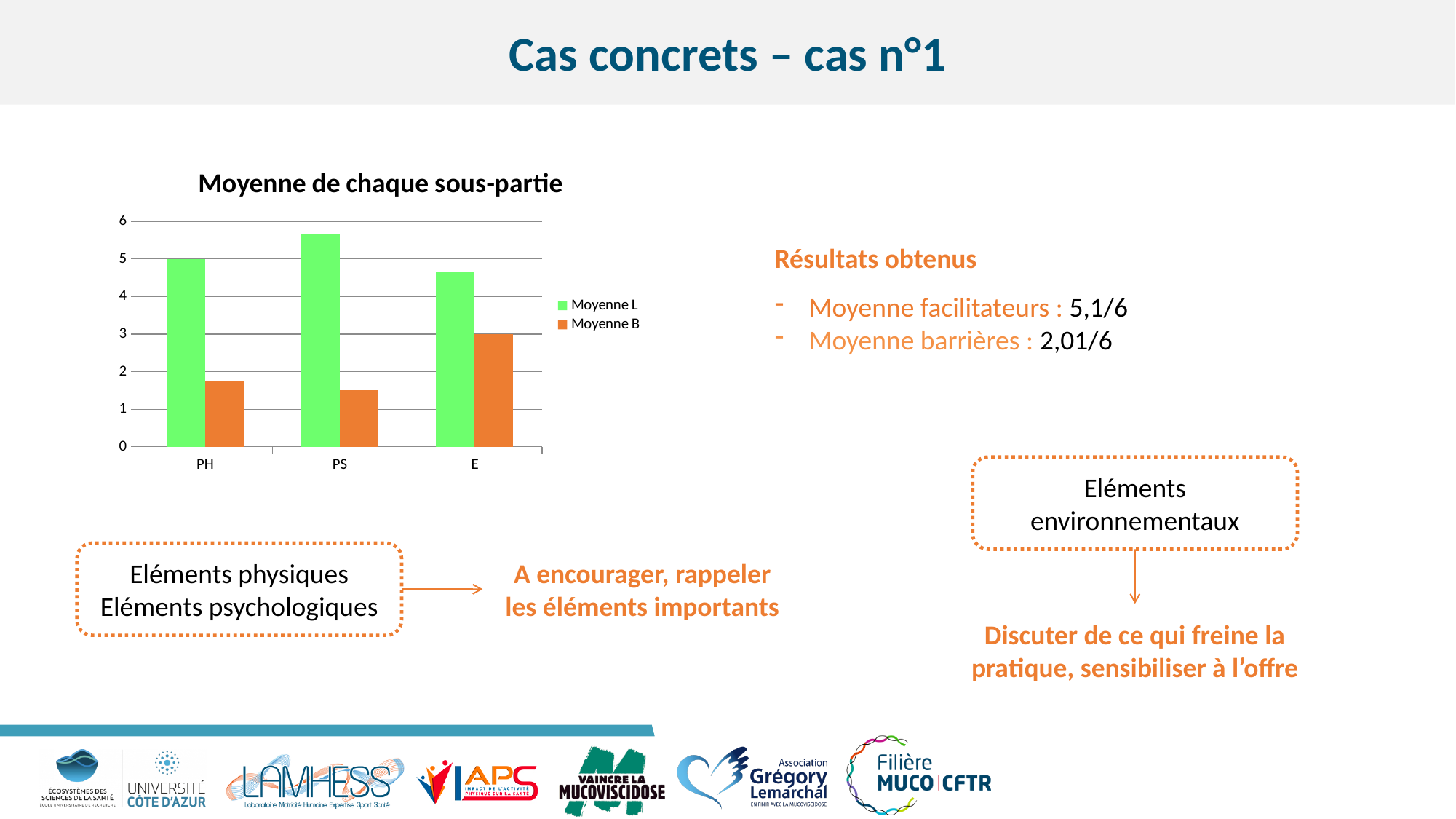
Is the Moyenne L value for PS greater or less than 5? greater What is the title of the chart? Moyenne de chaque sous-partie What is the value of Moyenne B for E? 3 How many categories are shown on the x axis of the chart? 3 Is the Moyenne B value for PH greater or less than 2? less Which category has the highest Moyenne L value? PS Which category has the lowest Moyenne B value? PS Which category has the highest Moyenne B value? E For category E, which is larger: Moyenne L or Moyenne B? Moyenne L What is the value of Moyenne L for PH? 5 What type of chart is shown on the slide? bar chart How many series does the chart legend list? 2